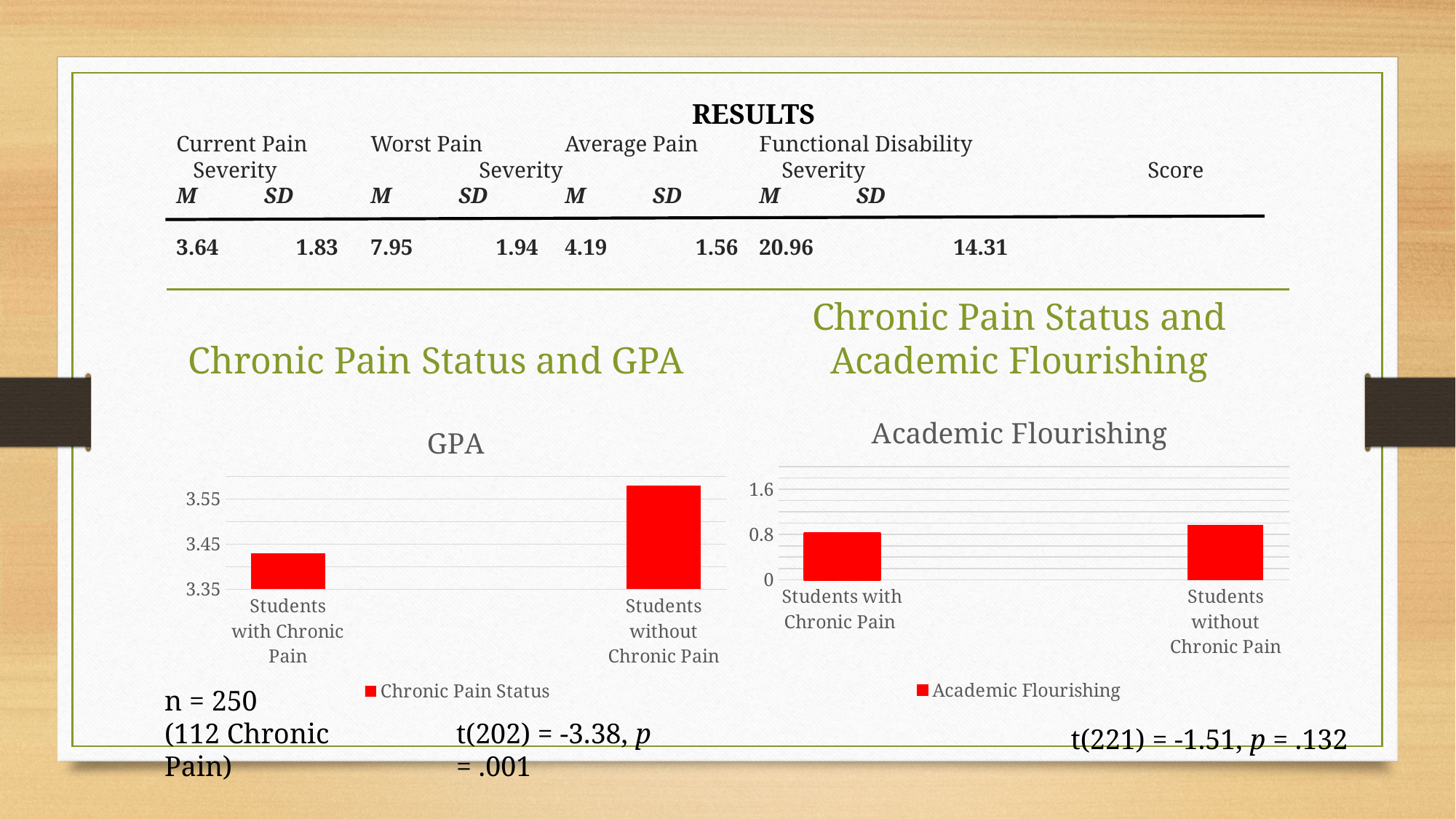
In the GPA chart, which category has the higher bar? Students without Chronic Pain In the GPA chart, is the value for Students without Chronic Pain greater or less than 3.55? greater In the Academic Flourishing chart, is the value for Students without Chronic Pain greater or less than 1.6? less In the Academic Flourishing chart, what kind of chart is used? bar chart In the GPA chart, what entry does the legend list? Chronic Pain Status In the GPA chart, is the value for Students with Chronic Pain greater or less than 3.45? less In the GPA chart, what kind of chart is used? bar chart In the GPA chart, how many categories are shown on the x axis? 2 In the Academic Flourishing chart, which category has the higher bar? Students without Chronic Pain In the Academic Flourishing chart, how many series does the legend list? 1 In the Academic Flourishing chart, is the bar for Students with Chronic Pain larger or smaller than the bar for Students without Chronic Pain? smaller In the GPA chart, which category has the lower bar? Students with Chronic Pain